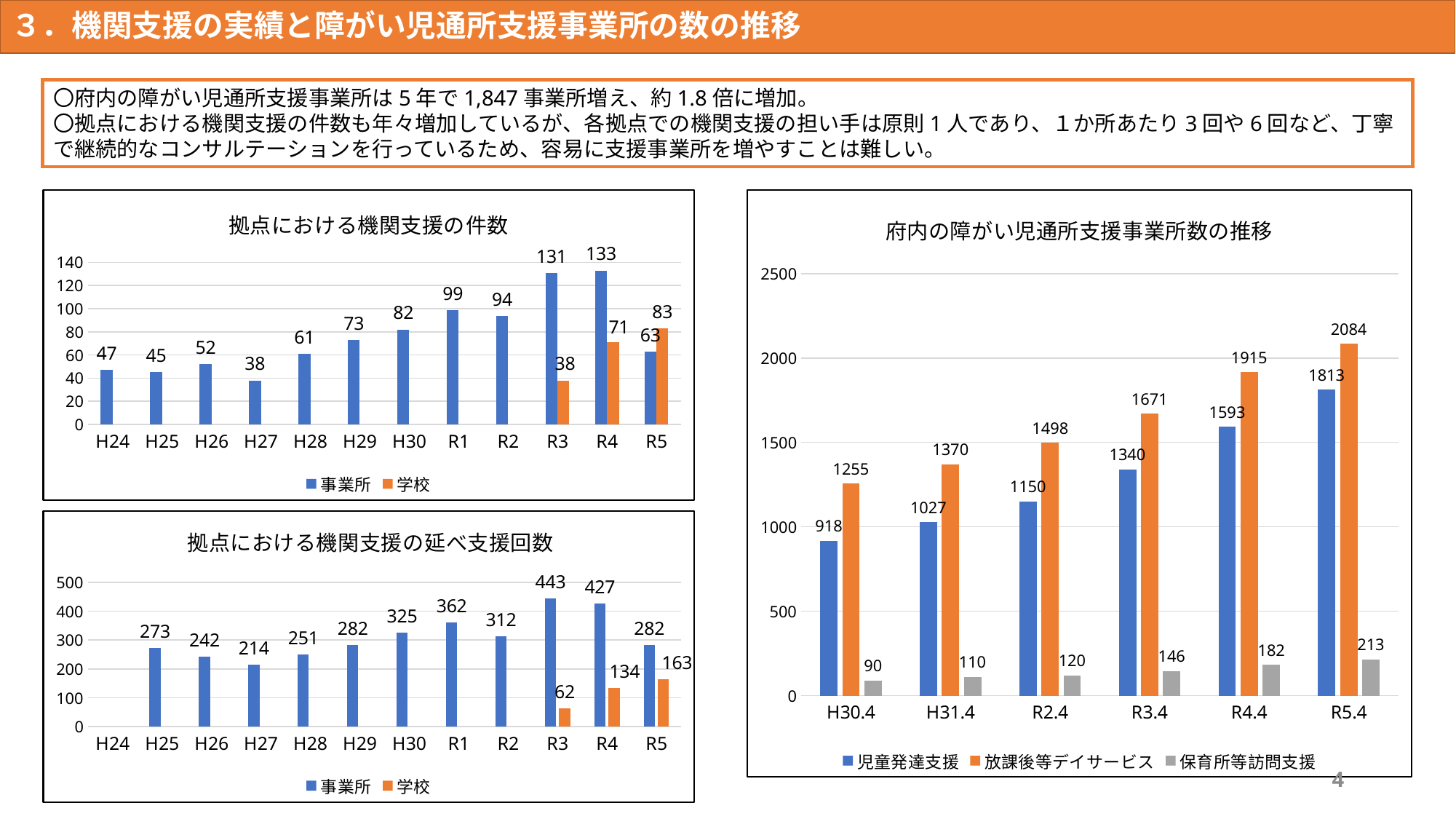
In the chart titled 拠点における機関支援の延べ支援回数, what is the value for 事業所 in R3? 443 In the chart titled 府内の障がい児通所支援事業所数の推移, do the values for 児童発達支援 rise or fall from H30.4 to R5.4? rise In the chart titled 府内の障がい児通所支援事業所数の推移, how many categories are shown on the x axis? 6 In the chart titled 拠点における機関支援の件数, which year has the lowest value for 事業所? H27 In the chart titled 拠点における機関支援の延べ支援回数, which is larger, the 事業所 value in R1 or in R2? R1 In the chart titled 拠点における機関支援の延べ支援回数, what kind of chart is it? bar chart In the chart titled 拠点における機関支援の件数, what is the difference between the 事業所 value and the 学校 value in R5? 20 In the chart titled 拠点における機関支援の件数, what is the value for 事業所 in R4? 133 In the chart titled 府内の障がい児通所支援事業所数の推移, what is the value for 放課後等デイサービス in R5.4? 2084 In the chart titled 府内の障がい児通所支援事業所数の推移, what is the total of the three series in H30.4? 2263 In the chart titled 拠点における機関支援の件数, how many series does the legend list? 2 In the chart titled 拠点における機関支援の延べ支援回数, which year has the highest value for 学校? R5